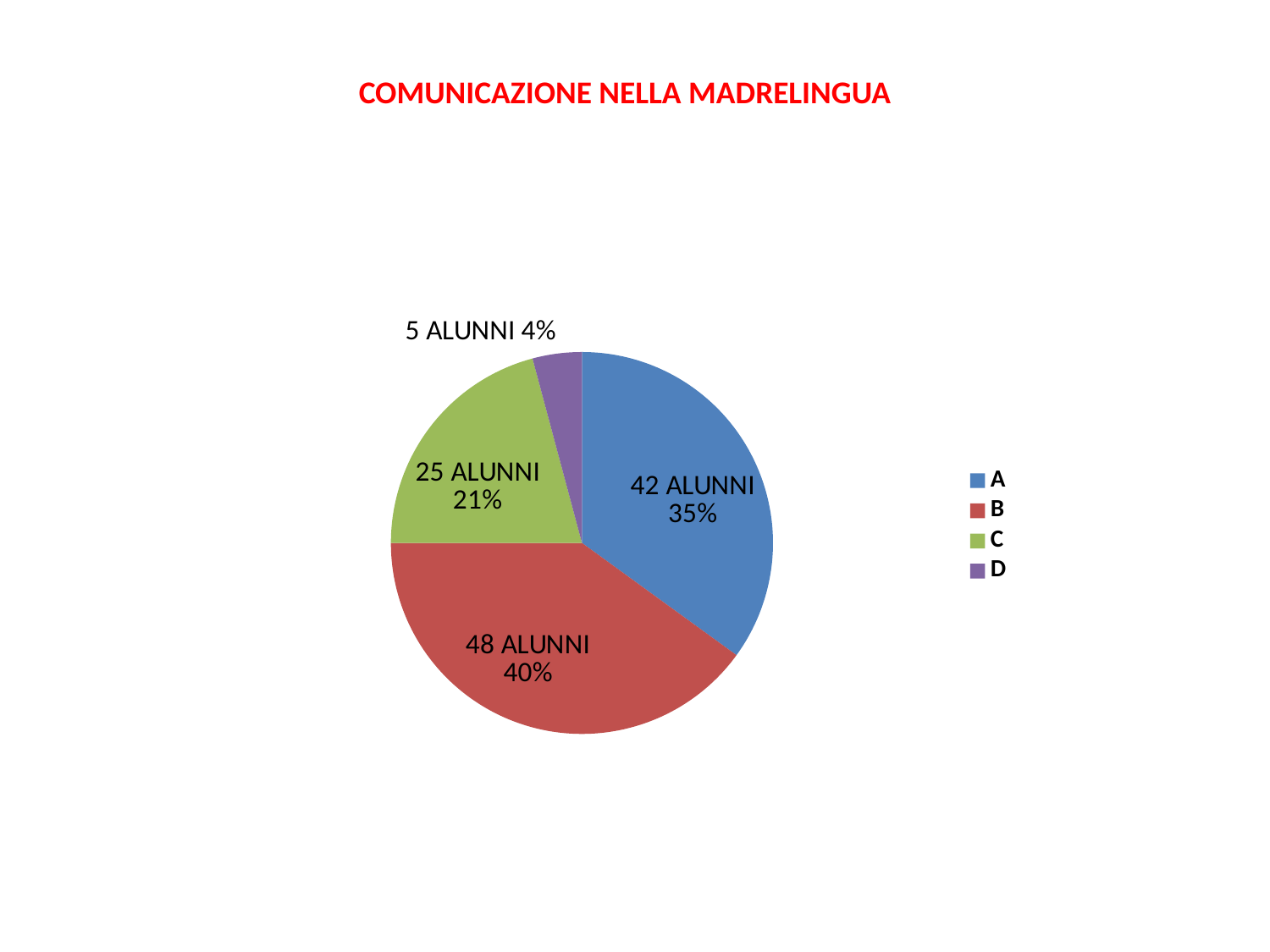
How many alunni are in category B? 48 ALUNNI What is the title of the slide? COMUNICAZIONE NELLA MADRELINGUA What share of the pie does category C represent? 21% How many slices does the pie chart have? 4 How many alunni are in category D? 5 ALUNNI What is the difference in alunni between category B and category A? 6 How many entries does the legend list? 4 What share of the pie does category B represent? 40% How many alunni are in category A? 42 ALUNNI What kind of chart is shown on the slide? pie chart Which category has the smallest slice? D Which category has the largest slice? B